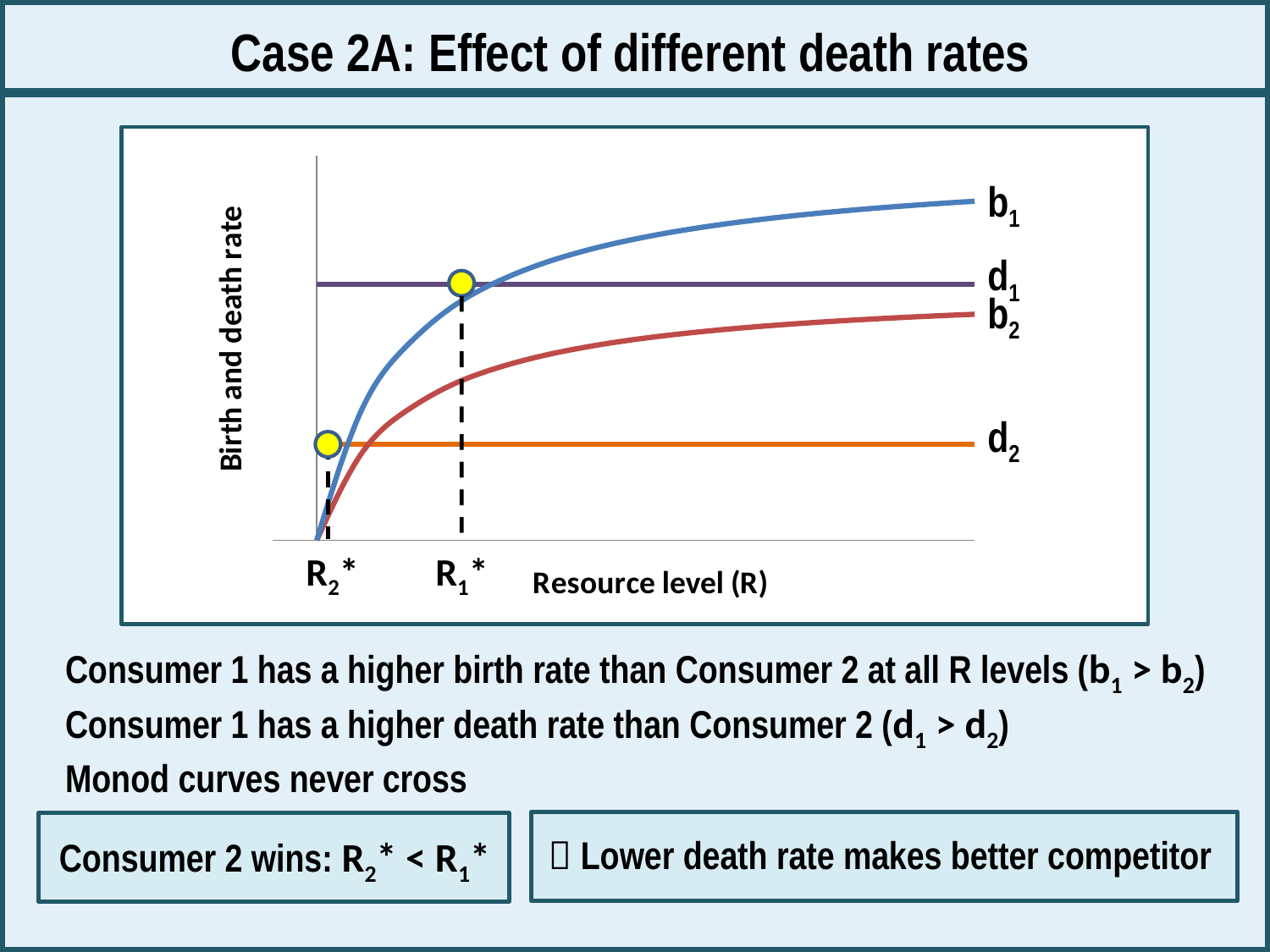
How many yellow circled points are marked on the chart? 2 Which labelled line is the lowest at the right end of the chart? d2 What is the label of the x axis of the chart? Resource level (R) Does the b1 curve rise or fall as the resource level R increases? Rises What is the label of the y axis of the chart? Birth and death rate Which is further to the left on the x axis, R1* or R2*? R2* How many curves are labelled on the chart? 4 Which death rate line is higher on the chart, d1 or d2? d1 Which birth rate curve is higher at high resource levels, b1 or b2? b1 Which curves intersect at the point marked R1*? b1 and d1 Which labelled curve reaches the highest value at the right end of the chart? b1 What kind of chart is shown on the slide? Line chart